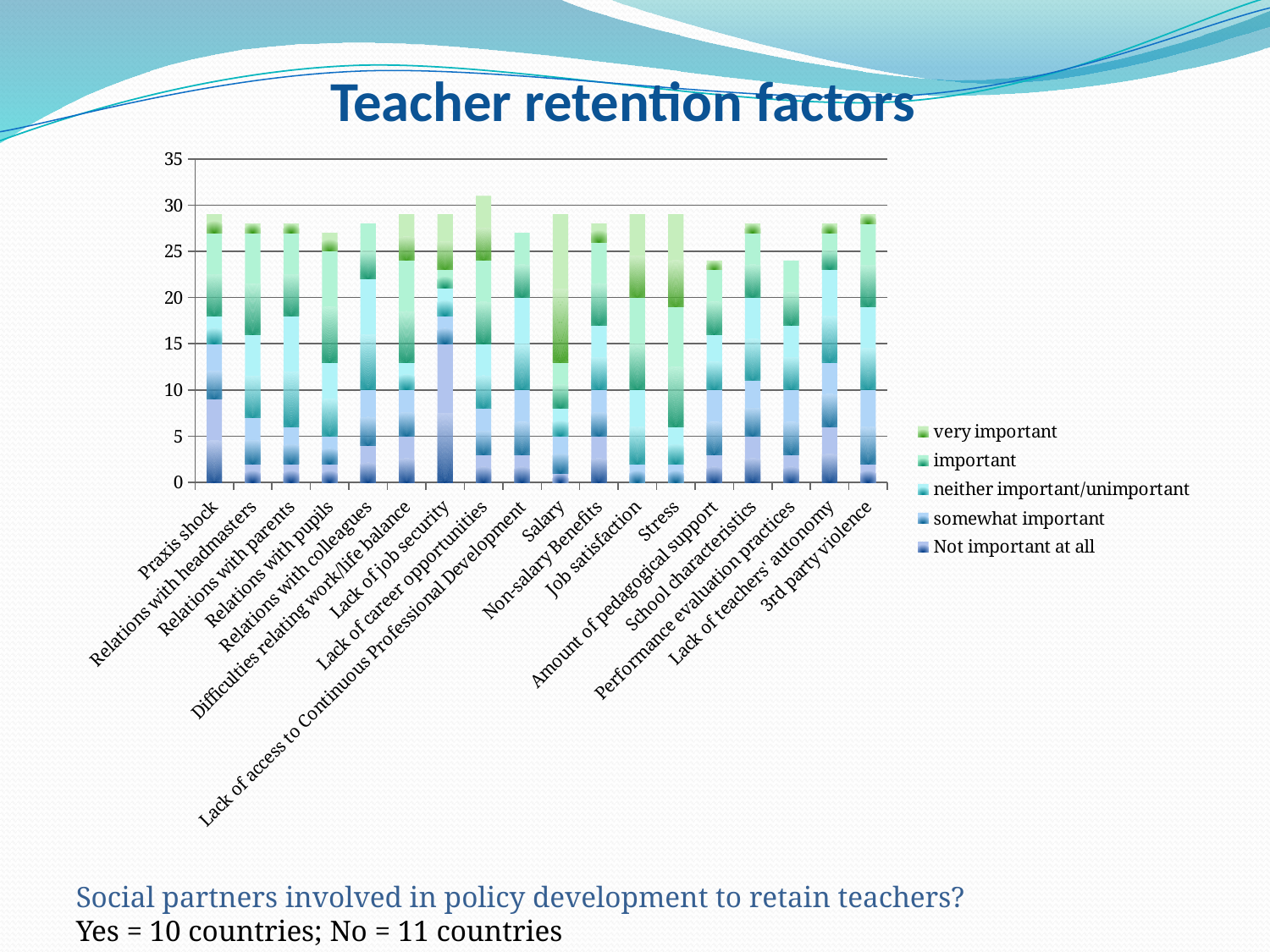
Which has the larger total stacked bar: Lack of career opportunities or Amount of pedagogical support? Lack of career opportunities Is the total stacked bar for Lack of career opportunities greater or less than 30? greater Is the total stacked bar for Amount of pedagogical support greater or less than 25? less What kind of chart is shown on the slide? Stacked bar chart How many categories (retention factors) are plotted along the x axis? 18 Which legend entry is listed first (at the top of the legend)? very important What is the title of the chart? Teacher retention factors Is the total stacked bar for Performance evaluation practices greater or less than 25? less How many series does the legend list? 5 Which category has the tallest stacked bar overall? Lack of career opportunities Which category has the larger 'Not important at all' segment: Lack of job security or Relations with headmasters? Lack of job security